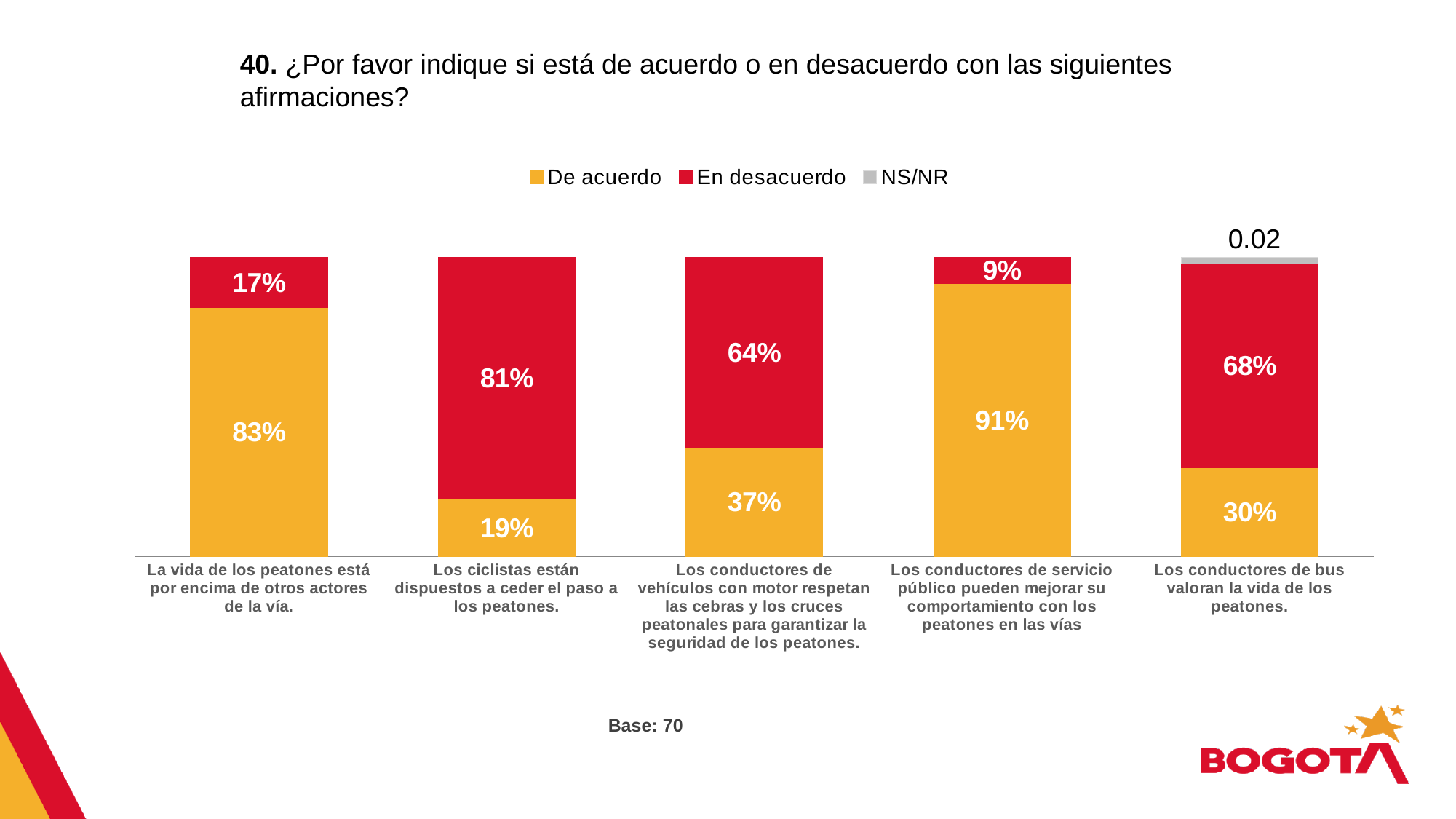
What is the base (number of respondents) shown below the chart? 70 What is the 'En desacuerdo' value for 'Los conductores de servicio público pueden mejorar su comportamiento con los peatones en las vías'? 9% How many series does the legend list? 3 What percentage of respondents disagree (En desacuerdo) that 'Los ciclistas están dispuestos a ceder el paso a los peatones'? 81% What is the difference between the 'En desacuerdo' and 'De acuerdo' values for 'Los conductores de vehículos con motor respetan las cebras y los cruces peatonales para garantizar la seguridad de los peatones'? 27% Which is larger: the 'De acuerdo' value for 'Los conductores de bus valoran la vida de los peatones' or the 'De acuerdo' value for 'Los conductores de vehículos con motor respetan las cebras y los cruces peatonales para garantizar la seguridad de los peatones'? Los conductores de vehículos con motor respetan las cebras y los cruces peatonales para garantizar la seguridad de los peatones Which statement has the lowest 'De acuerdo' percentage? Los ciclistas están dispuestos a ceder el paso a los peatones What is the 'De acuerdo' value for 'Los conductores de bus valoran la vida de los peatones'? 30% Which statement has the highest 'De acuerdo' percentage? Los conductores de servicio público pueden mejorar su comportamiento con los peatones en las vías How many statements (categories) are shown in the chart? 5 What kind of chart is shown on the slide? Stacked bar chart What percentage of respondents agree (De acuerdo) that 'La vida de los peatones está por encima de otros actores de la vía'? 83%